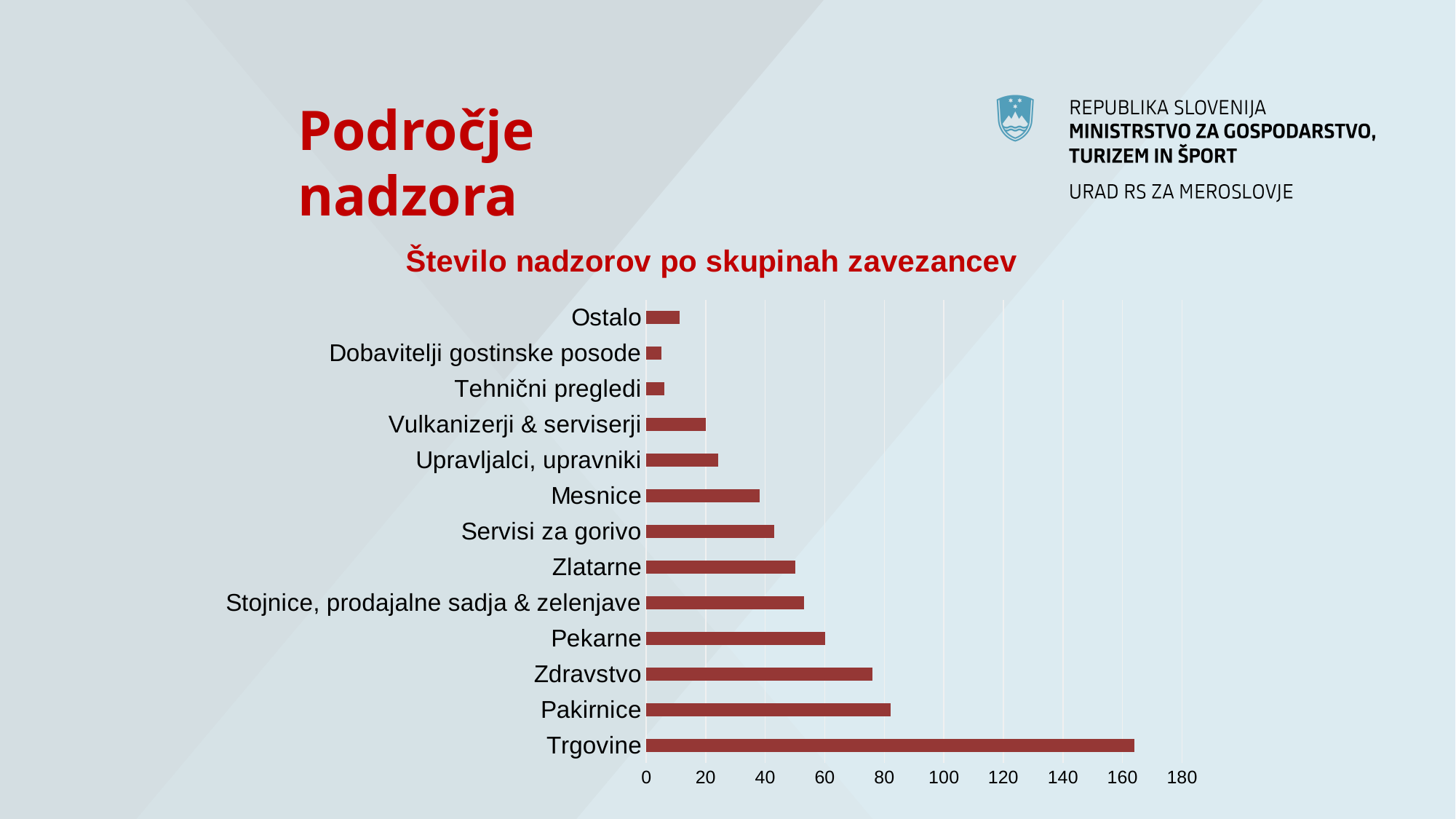
Is the value for Zdravstvo greater or less than 80? less Which category has the highest number of inspections? Trgovine Is the value for Zlatarne greater or less than 40? greater Is the value for Trgovine greater or less than 140? greater How many categories are shown in the chart? 13 Which has a larger value, Pekarne or Mesnice? Pekarne Do the bar values increase or decrease going from the top category to the bottom category? increase Which has a larger value, Trgovine or Pakirnice? Trgovine What is the title of the chart? Število nadzorov po skupinah zavezancev What kind of chart is shown on the slide? Bar chart